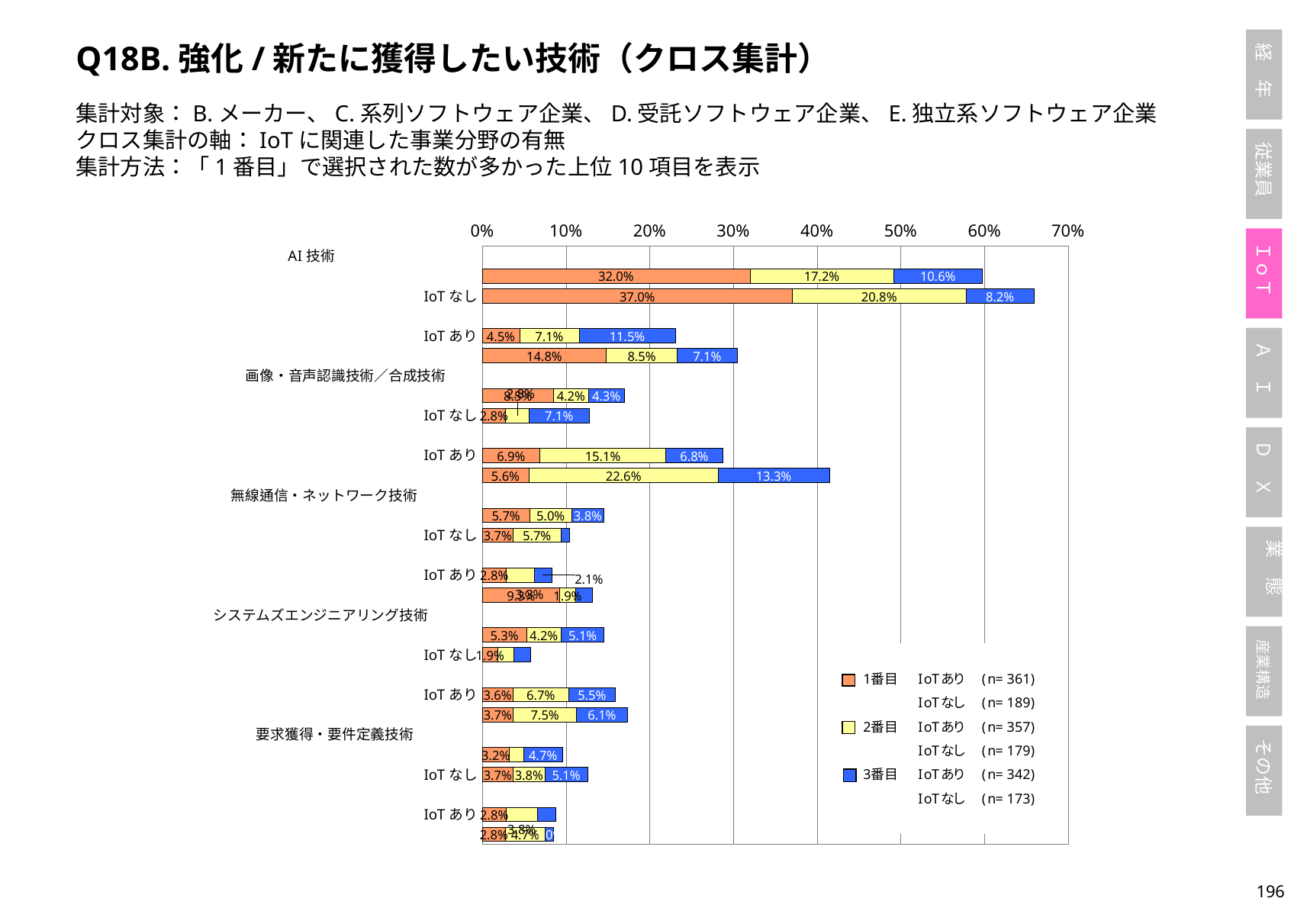
What is the total of the topmost bar (AI 技術), summing 1番目, 2番目 and 3番目? 59.8% What is the difference between the 1番目 values of the second bar (37.0%) and the topmost bar (32.0%)? 5.0 percentage points What is the sample size (n) shown in the legend for 1番目 IoT あり? 361 What is the 3番目 value for the topmost bar (AI 技術)? 10.6% What kind of chart is shown on the slide? Stacked horizontal bar chart What are the three series names in the legend? 1番目, 2番目, 3番目 Which bar has the largest 1番目 value in the chart? The second bar from the top (AI 技術, IoT なし), 37.0% What is the 1番目 value for the topmost bar (AI 技術)? 32.0% What is the total of the second bar from the top (AI 技術, IoT なし)? 66.0% What is the 1番目 value for the IoT なし bar under AI 技術 (second bar from the top)? 37.0% How many series does the legend list? 3 Which is larger: the 2番目 value of the topmost bar or the 2番目 value of the second bar from the top? The second bar (20.8%)